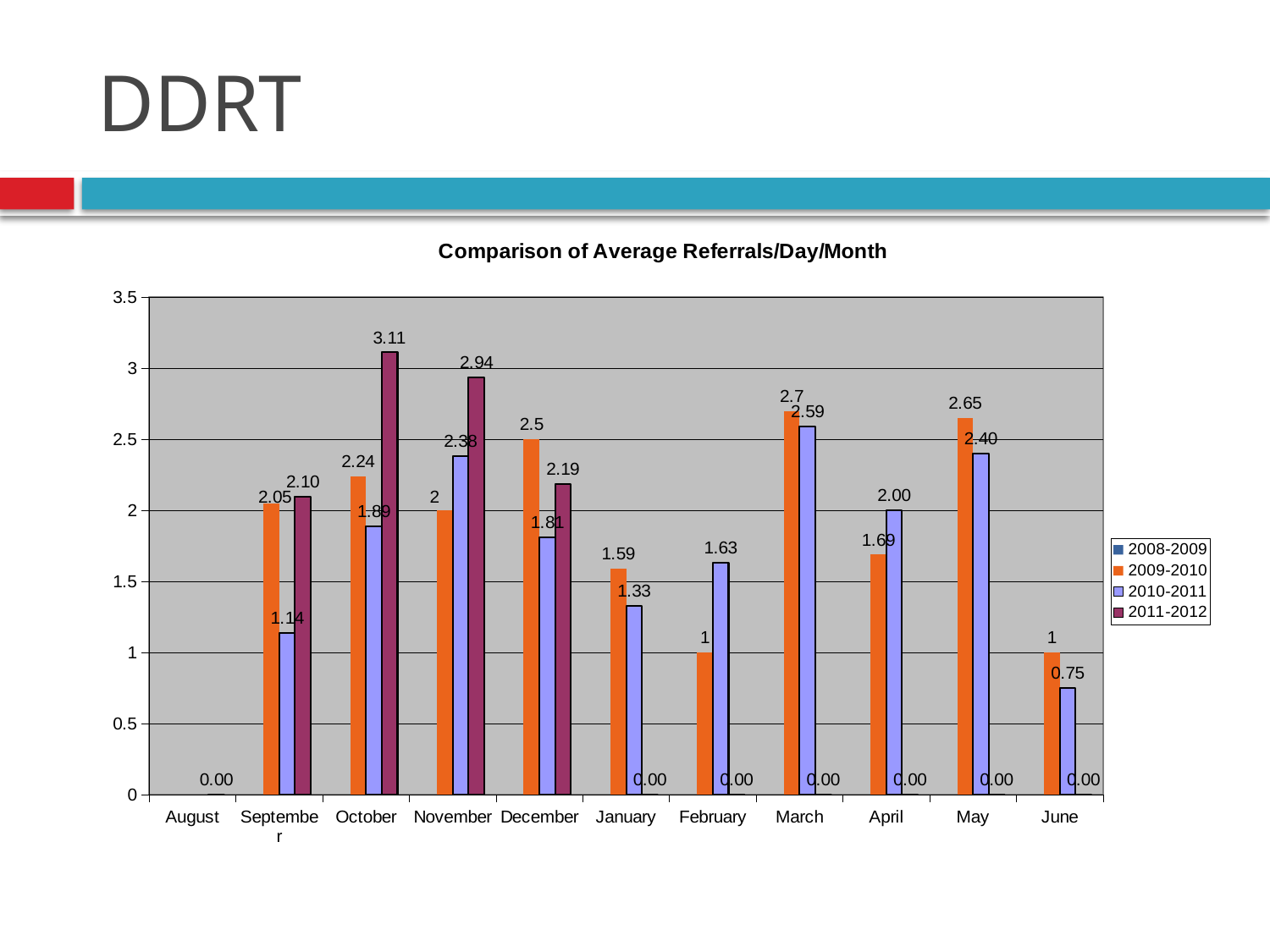
How many months are shown on the x axis? 11 What is the value for 2010-2011 in September? 1.14 What is the value for 2011-2012 in October? 3.11 How many series does the legend list? 4 What is the highest value shown on the chart, and in which month and series does it occur? 3.11, October, 2011-2012 In March, which series has the larger value, 2009-2010 or 2010-2011? 2009-2010 Which month has the lowest non-zero value for the 2010-2011 series? June In May, what is the difference between the 2009-2010 value and the 2010-2011 value? 0.25 What is the value for 2009-2010 in December? 2.5 What is the title of the chart? Comparison of Average Referrals/Day/Month In October, what is the difference between the 2011-2012 value and the 2010-2011 value? 1.22 Which month has the highest value for the 2009-2010 series? March